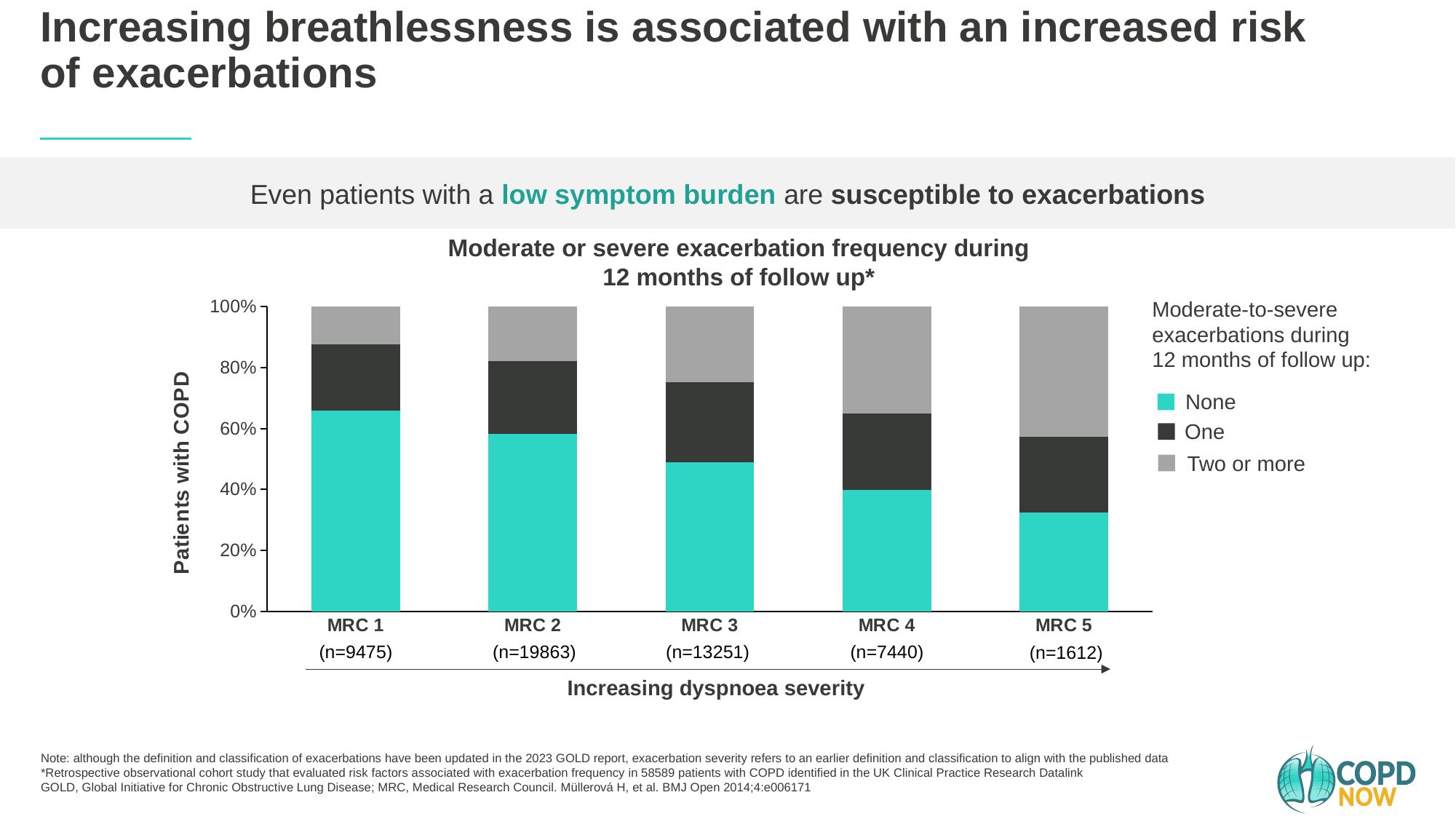
Which has the larger 'Two or more' share: MRC 1 or MRC 5? MRC 5 How many MRC categories are plotted along the x axis? 5 Does the share of patients with no exacerbations (None) rise or fall from MRC 1 to MRC 5? Fall Is the 'None' share for MRC 1 greater or less than 60%? greater Is the 'None' share for MRC 5 greater or less than 40%? less How many series does the legend list? 3 What is the title of the chart? Moderate or severe exacerbation frequency during 12 months of follow up* Is the 'None' share for MRC 2 greater or less than 40%? greater What are the three legend entries of the chart? None, One, Two or more Which MRC category has the largest share of patients with no exacerbations (None)? MRC 1 Which MRC category has the smallest share of patients with no exacerbations (None)? MRC 5 What kind of chart is shown on the slide? Stacked bar chart